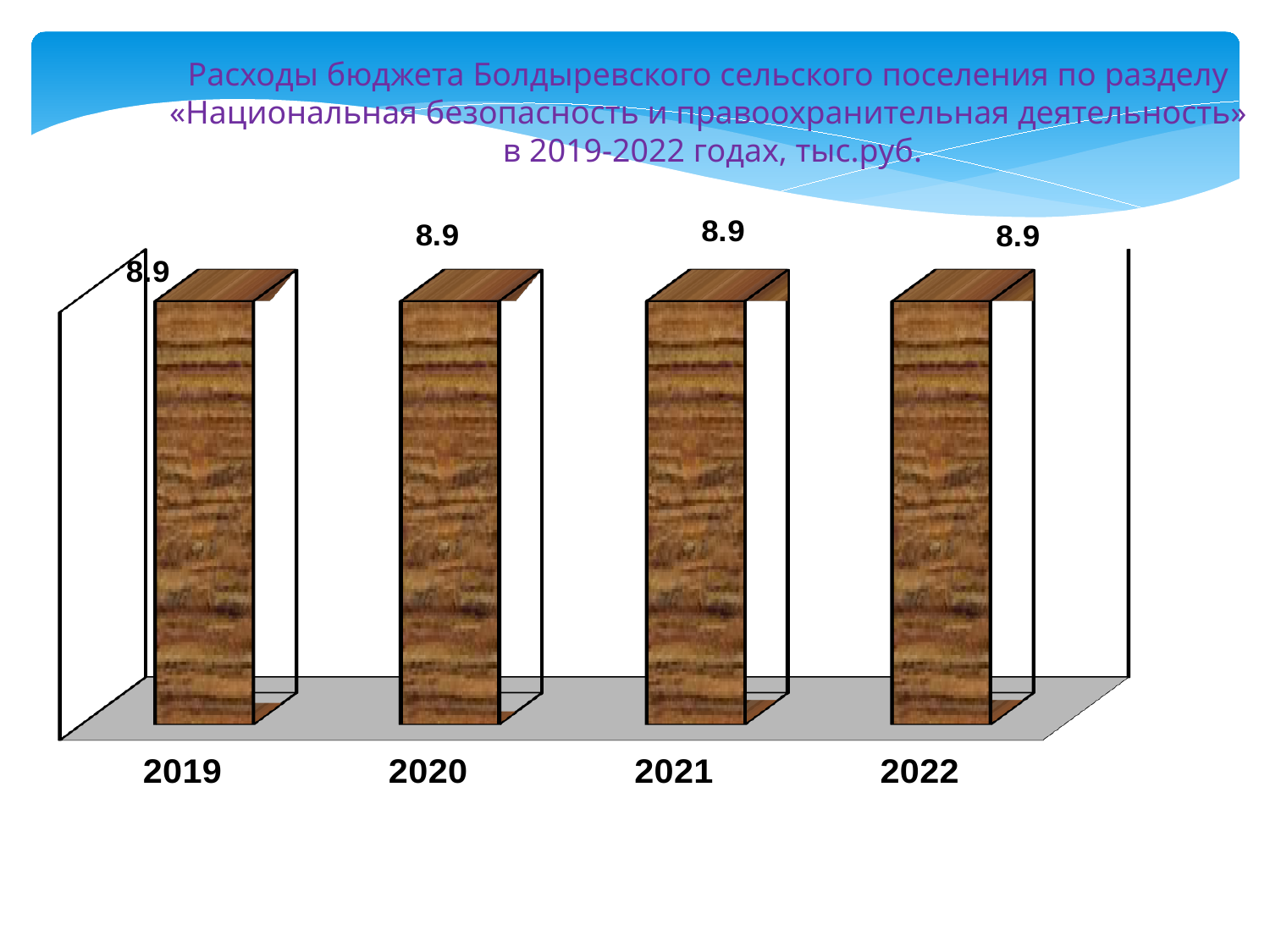
What kind of chart is shown on the slide? Bar chart What is the difference between the values for 2022 and 2019? 0 What is the value for 2019? 8.9 How many years (categories) are shown on the chart? 4 Is the value for 2020 larger than, smaller than, or equal to the value for 2021? Equal What is the value for 2020? 8.9 Do the values rise, fall or stay the same from 2019 to 2022? Stay the same In what units are the values on the chart expressed, according to the title? тыс.руб. What is the value for 2021? 8.9 Which budget section does the chart title say the expenditures refer to? «Национальная безопасность и правоохранительная деятельность» What is the first year shown on the x axis? 2019 What is the value for 2022? 8.9